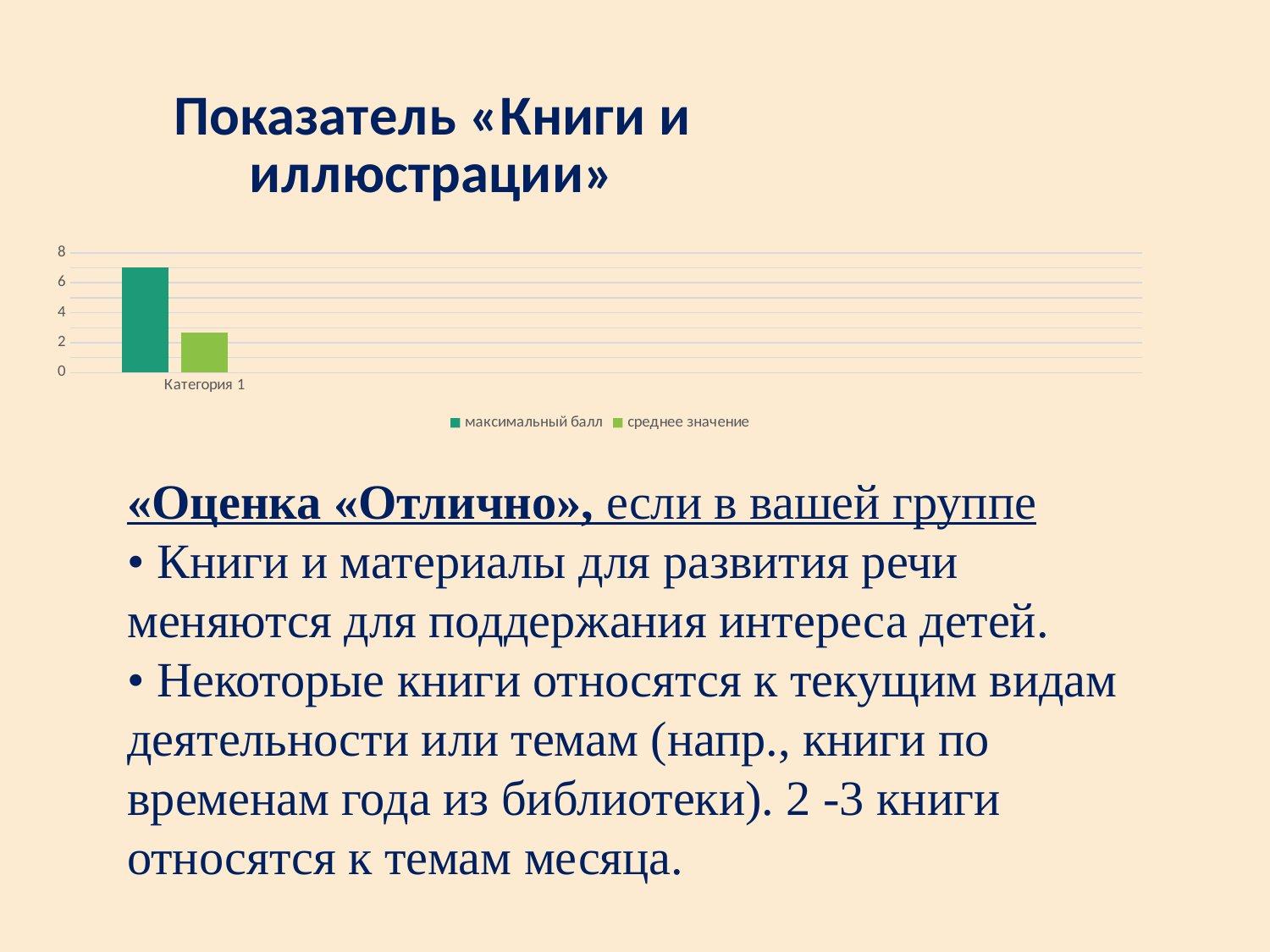
How many categories are shown on the x axis of the chart? 1 Is the value for максимальный балл greater or less than 6? greater What kind of chart is shown on the slide? bar chart What is the label of the category on the x axis of the chart? Категория 1 What is the highest value shown on the chart's vertical axis? 8 How many series does the chart legend list? 2 Is the value for среднее значение greater or less than 4? less Which series has the taller bar for Категория 1, максимальный балл or среднее значение? максимальный балл Is the value for максимальный балл greater or less than 8? less Which series has the highest value in the chart? максимальный балл Which series has the lowest value in the chart? среднее значение